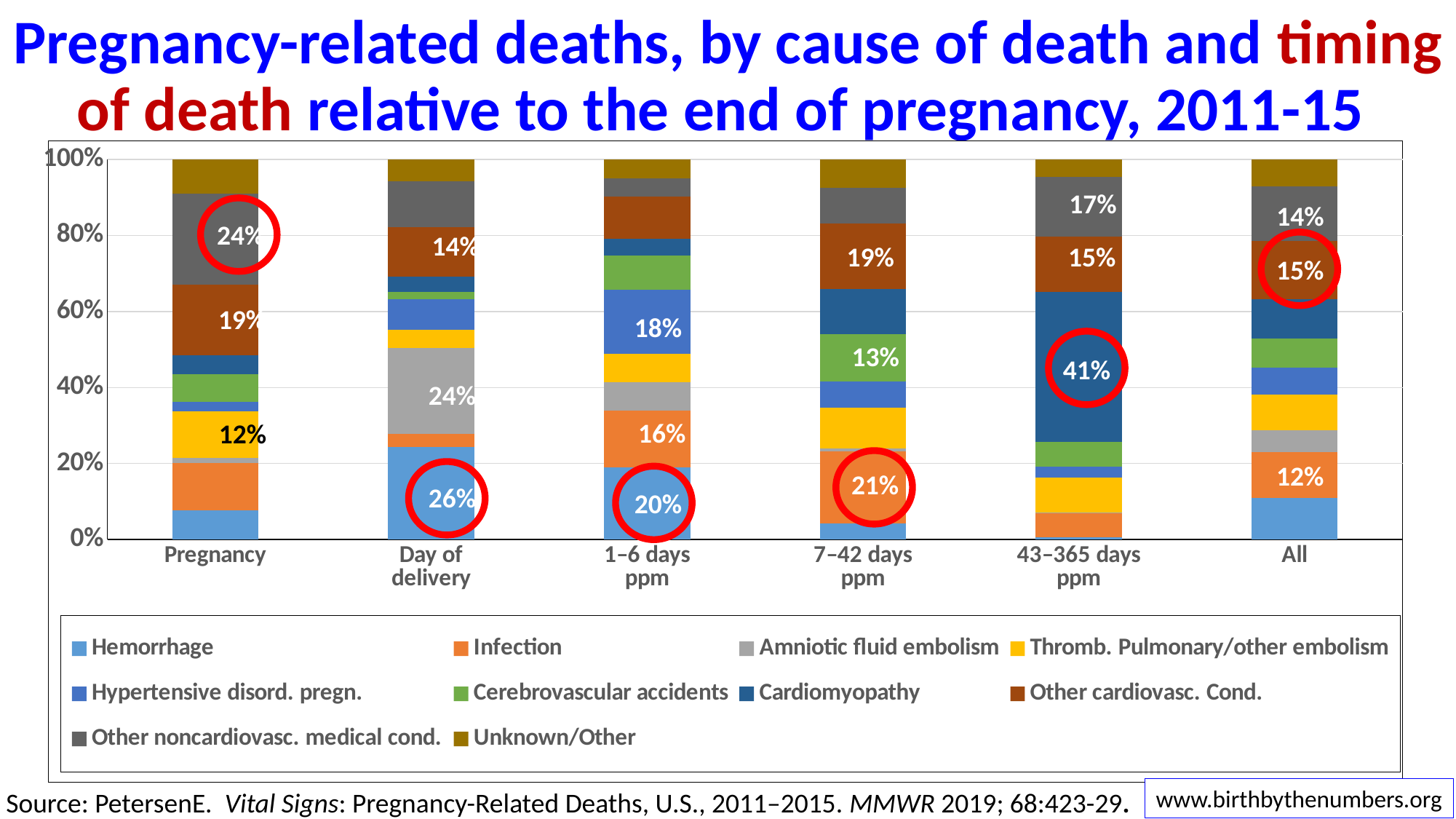
What share of deaths in the 43–365 days ppm category is attributed to Cardiomyopathy? 41% What percentage of deaths in the 7–42 days ppm category were due to Infection? 21% Which timing category has the largest share of deaths due to Cardiomyopathy? 43–365 days ppm How many percentage points higher is the Hemorrhage share on the Day of delivery than in the 1–6 days ppm category? 6 percentage points What percentage of pregnancy-related deaths on the Day of delivery were due to Hemorrhage? 26% What type of chart is shown on the slide? Stacked bar chart How many timing categories are shown along the x axis? 6 What is the labelled value for Other noncardiovasc. medical cond. in the Pregnancy bar? 24% Which has a larger share of Other cardiovasc. Cond. deaths: Pregnancy or 43–365 days ppm? Pregnancy How many causes of death does the legend list? 10 What is the labelled value for Amniotic fluid embolism on the Day of delivery? 24% Is the Hemorrhage share in the Pregnancy bar greater or less than 10%? less